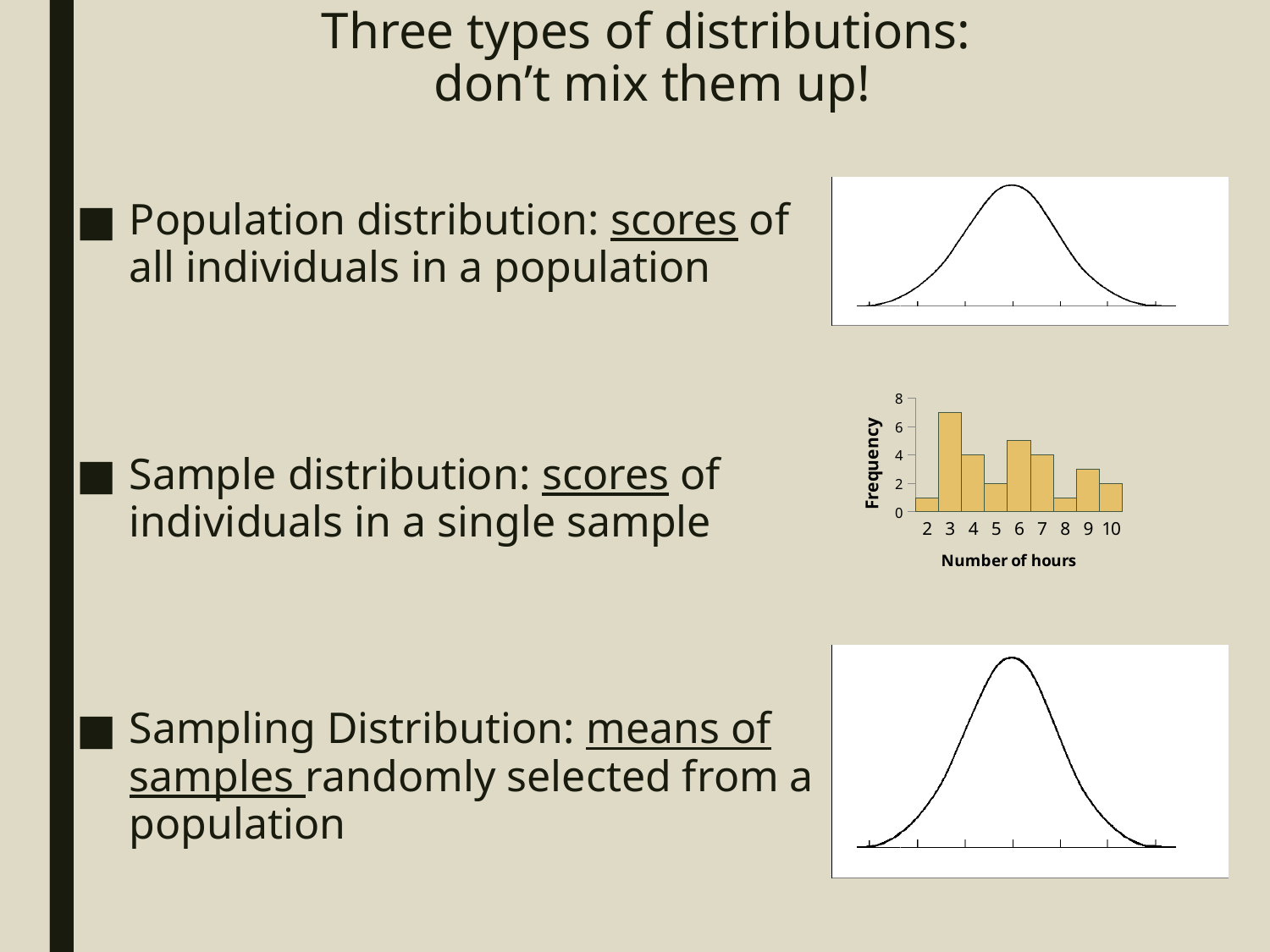
On the bar chart in the middle of the slide, what is the frequency for 5 hours? 2 On the bar chart in the middle of the slide, which has a higher frequency: 6 hours or 9 hours? 6 hours On the bar chart in the middle of the slide, what is the difference between the frequency for 4 hours and the frequency for 5 hours? 2 On the bar chart in the middle of the slide, what is the frequency for 7 hours? 4 On the bar chart in the middle of the slide, is the frequency for 6 hours greater or less than 4? greater How many bars are shown on the bar chart in the middle of the slide? 9 On the bar chart in the middle of the slide, which number of hours has the highest frequency? 3 On the bar chart in the middle of the slide, is the frequency for 8 hours greater or less than 2? less What is the x-axis title of the bar chart in the middle of the slide? Number of hours On the bar chart in the middle of the slide, is the frequency for 3 hours greater or less than 6? greater On the bar chart in the middle of the slide, what is the frequency for 10 hours? 2 On the bar chart in the middle of the slide, what is the frequency for 4 hours? 4